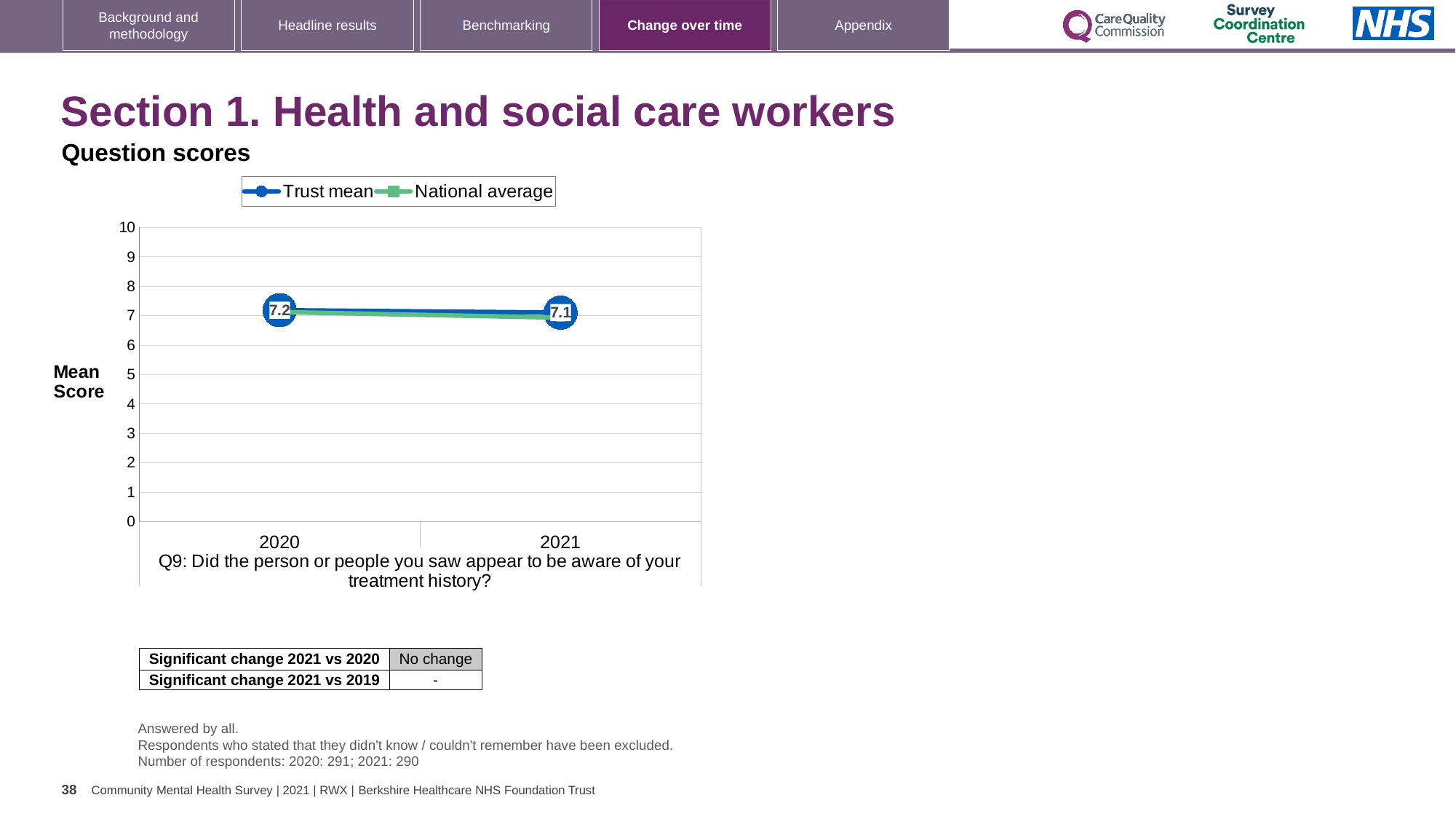
What is the Trust mean score for 2020? 7.2 In which year is the Trust mean score higher? 2020 In which year is the Trust mean score lower? 2021 What kind of chart is shown on the slide? Line chart How many series does the chart legend list? 2 What is the Trust mean score for 2021? 7.1 What is the difference between the Trust mean score in 2020 and in 2021? 0.1 Which is larger, the Trust mean score for 2020 or for 2021? 2020 How many years are shown on the x axis of the chart? 2 Is the National average value for 2020 greater or less than 5? greater What are the two series named in the chart legend? Trust mean and National average Does the Trust mean score rise or fall from 2020 to 2021? Fall